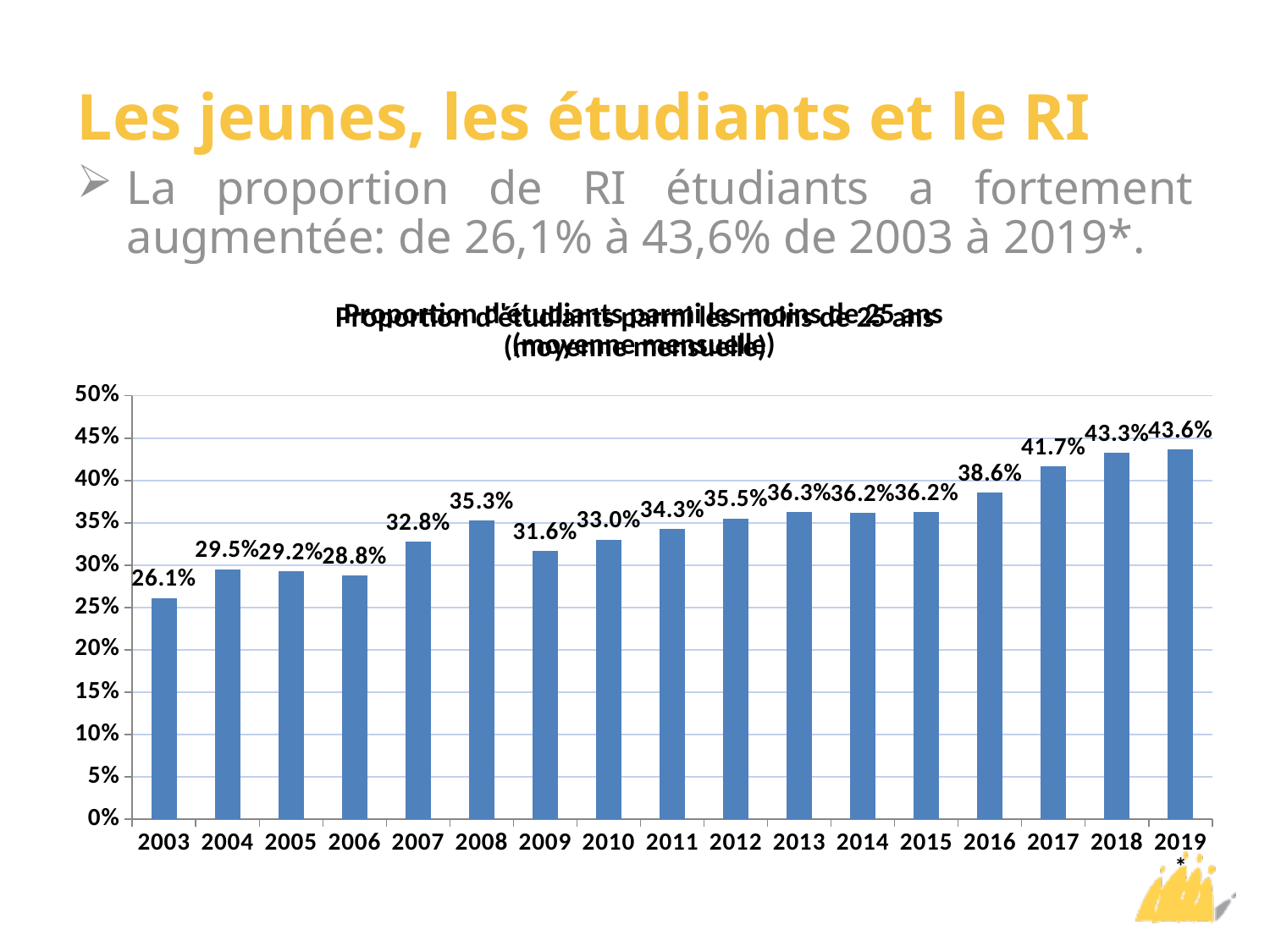
Which year has the lowest value? 2003 What is the value for 2009? 31.6% Which is larger, the value for 2008 or the value for 2009? 2008 What is the difference between the values for 2017 and 2016? 3.1% Do the values generally rise or fall from 2003 to 2019? rise What type of chart is shown on the slide? bar chart Is the value for 2012 greater or less than 30%? greater What is the difference between the values for 2019 and 2003? 17.5% What is the value for 2003? 26.1% What is the value for 2016? 38.6% How many years are shown on the x axis? 17 Which year has the highest value? 2019